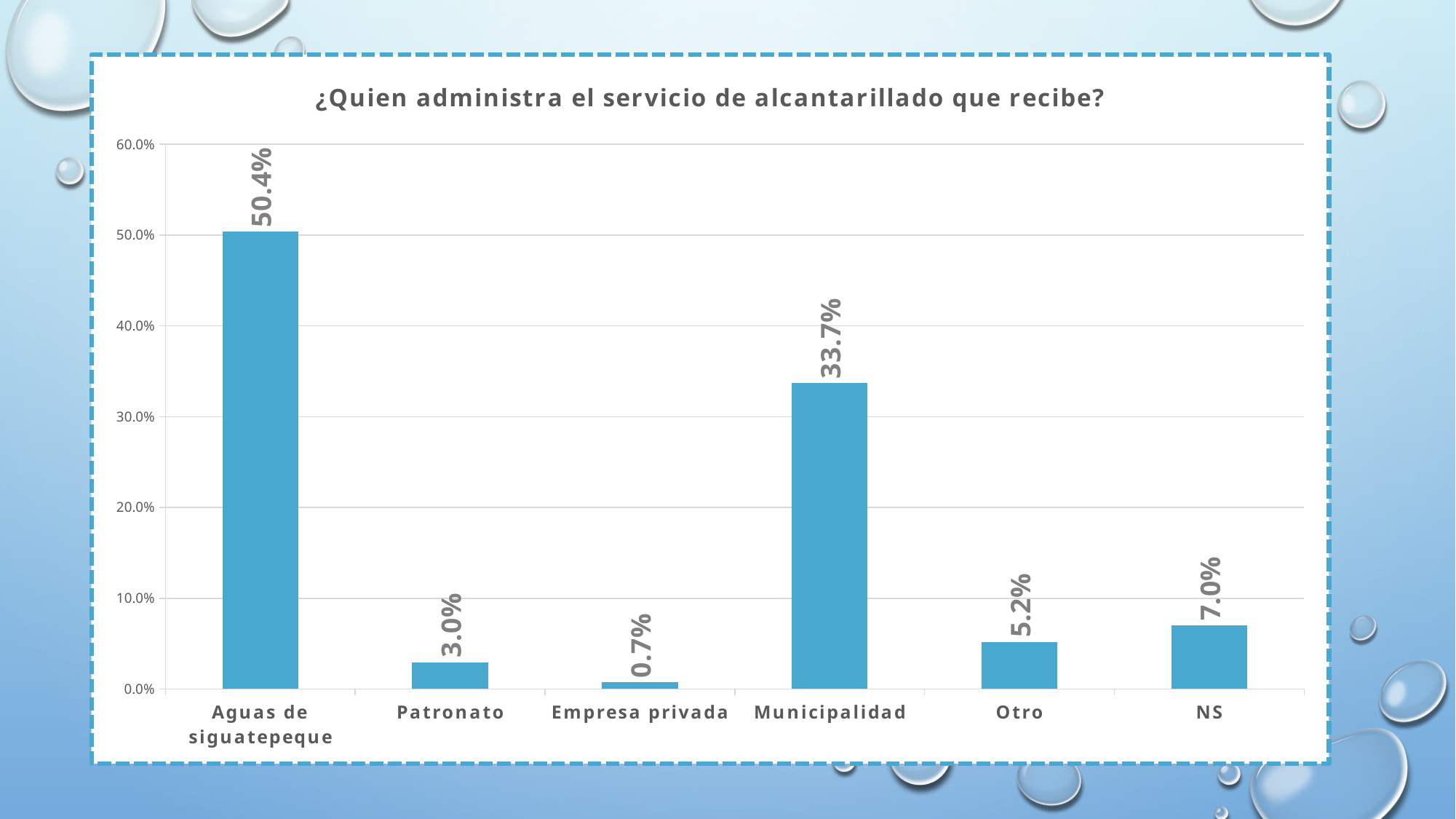
Which category has the lowest value? Empresa privada What is the title of the chart? ¿Quien administra el servicio de alcantarillado que recibe? How many categories are shown on the x axis? 6 Which is larger, the value for Otro or the value for NS? NS What kind of chart is shown on the slide? Bar chart Is the value for Municipalidad greater or less than 30.0%? greater What is the value for NS? 7.0% What is the value for Aguas de siguatepeque? 50.4% What is the value for Empresa privada? 0.7% Which category has the highest value? Aguas de siguatepeque What is the difference between the values for Aguas de siguatepeque and Municipalidad? 16.7% What is the value for Municipalidad? 33.7%